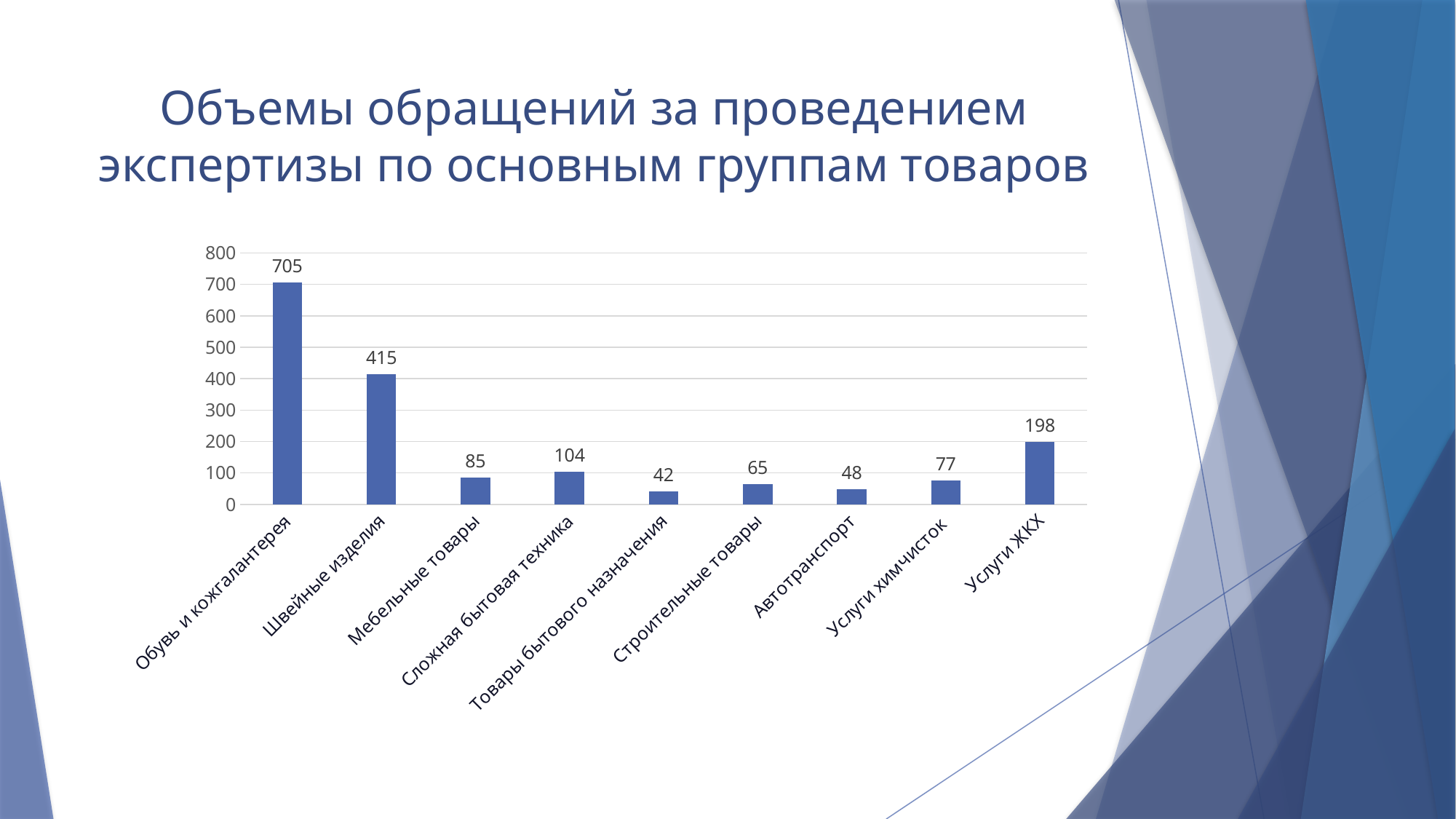
What is the title of the chart on the slide? Объемы обращений за проведением экспертизы по основным группам товаров Is the value for Швейные изделия greater or less than 400? greater What is the value for Обувь и кожгалантерея? 705 What is the value for Сложная бытовая техника? 104 How many categories are shown on the chart? 9 Which category has the lowest value? Товары бытового назначения What kind of chart is shown on the slide? bar chart What is the difference between the values for Обувь и кожгалантерея and Швейные изделия? 290 What is the difference between the values for Строительные товары and Автотранспорт? 17 Which is larger, the value for Мебельные товары or the value for Услуги химчисток? Мебельные товары Which category has the highest value? Обувь и кожгалантерея What is the value for Услуги ЖКХ? 198